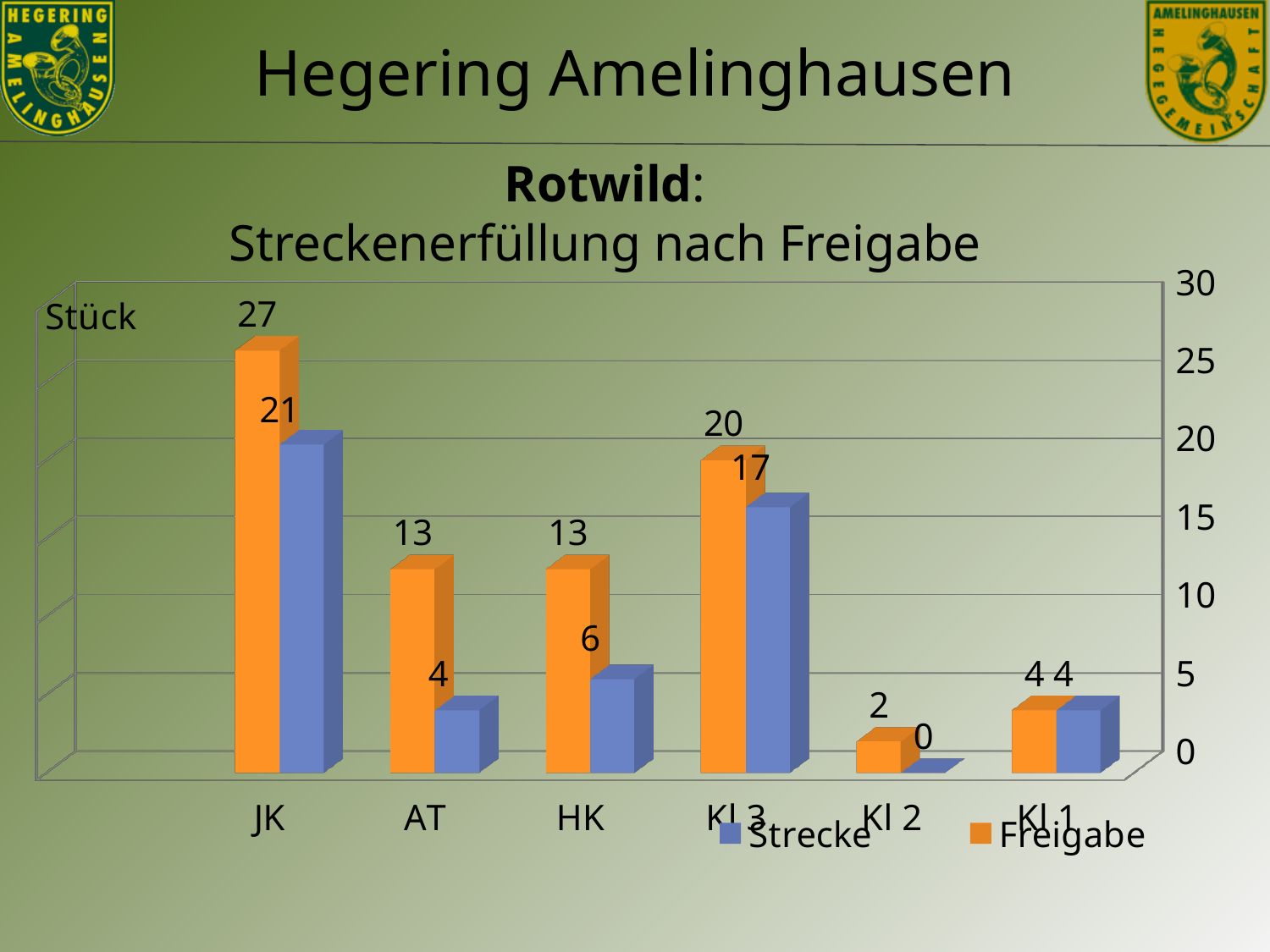
Which is larger for Kl 3, Freigabe or Strecke? Freigabe How many series does the legend list? 2 What kind of chart is shown on the slide? Bar chart What is the Strecke value for Kl 3? 17 Which category has the lowest Freigabe value? Kl 2 What is the difference between Freigabe and Strecke for AT? 9 What is the Strecke value for HK? 6 How many categories are shown on the x axis? 6 Which colour represents the Strecke series? Blue What is the Strecke value for Kl 2? 0 Which category has the highest Freigabe value? JK What is the Freigabe value for JK? 27